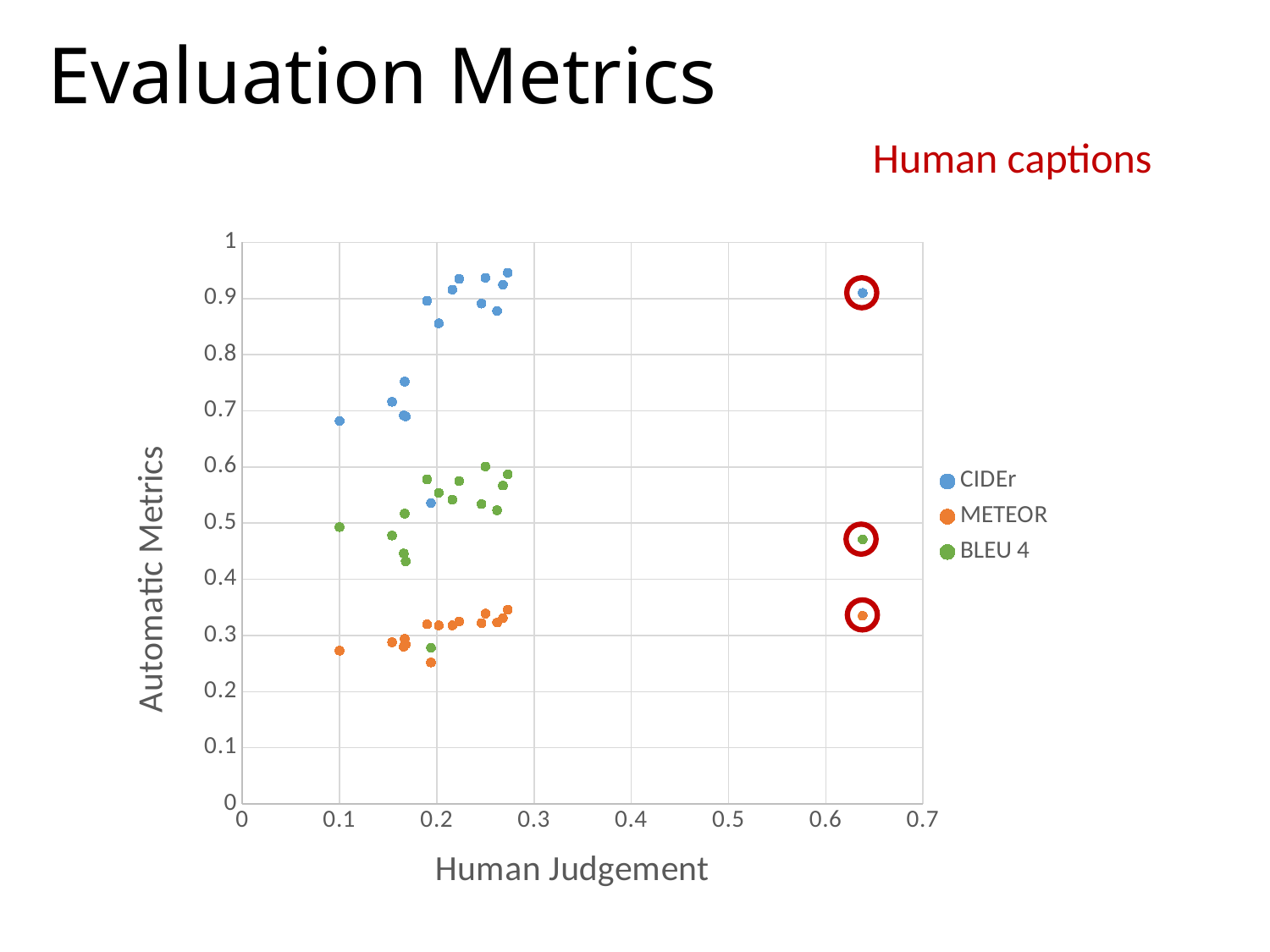
At human judgement 0.1, which series has the larger value, CIDEr or BLEU 4? CIDEr Is the CIDEr value at human judgement 0.1 greater or less than 0.6? greater What do the red circles on the chart mark, according to the red annotation? Human captions What is the label of the x axis? Human Judgement Is the CIDEr value for the circled human-captions point (human judgement about 0.64) greater or less than 0.8? greater What kind of chart is shown on the slide? Scatter chart Do the CIDEr values generally rise or fall as human judgement increases from 0.1 to 0.3? rise How many series does the legend list? 3 Which series has the highest automatic metric values overall? CIDEr Is the BLEU 4 value for the circled human-captions point (human judgement about 0.64) greater or less than 0.5? less Which series has the lowest automatic metric values overall? METEOR